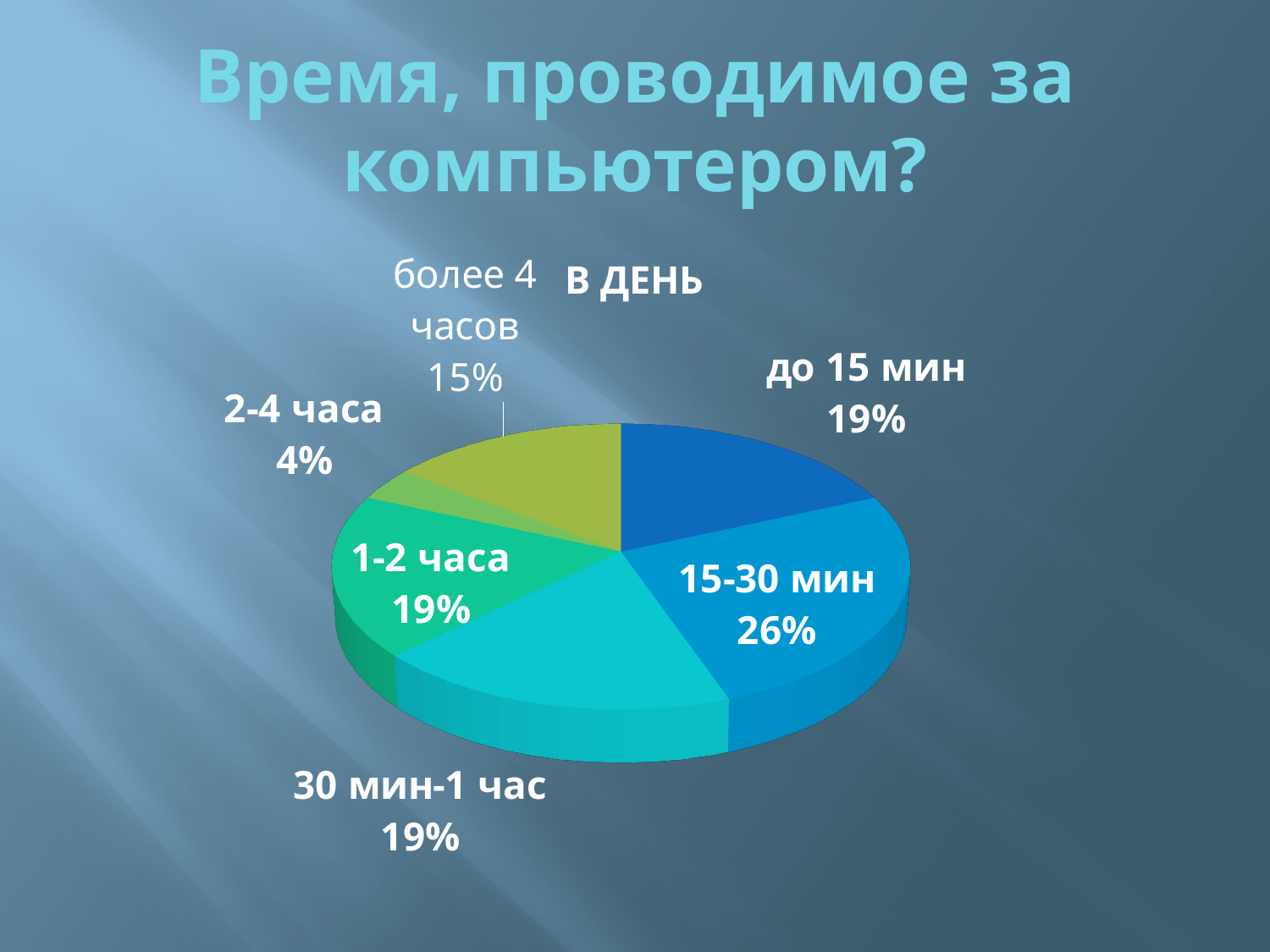
What share of the pie is labelled "15-30 мин"? 26% What is the chart's title? В ДЕНЬ Which category has the smallest share of the pie? 2-4 часа What share of the pie is labelled "до 15 мин"? 19% Which is larger: the share for "более 4 часов" or the share for "2-4 часа"? более 4 часов What share of the pie is labelled "2-4 часа"? 4% What is the difference in percentage points between "15-30 мин" and "более 4 часов"? 11 Which category has the largest share of the pie? 15-30 мин How many categories share the value 19%? 3 What kind of chart is shown on the slide? pie chart How many slices does the pie chart have? 6